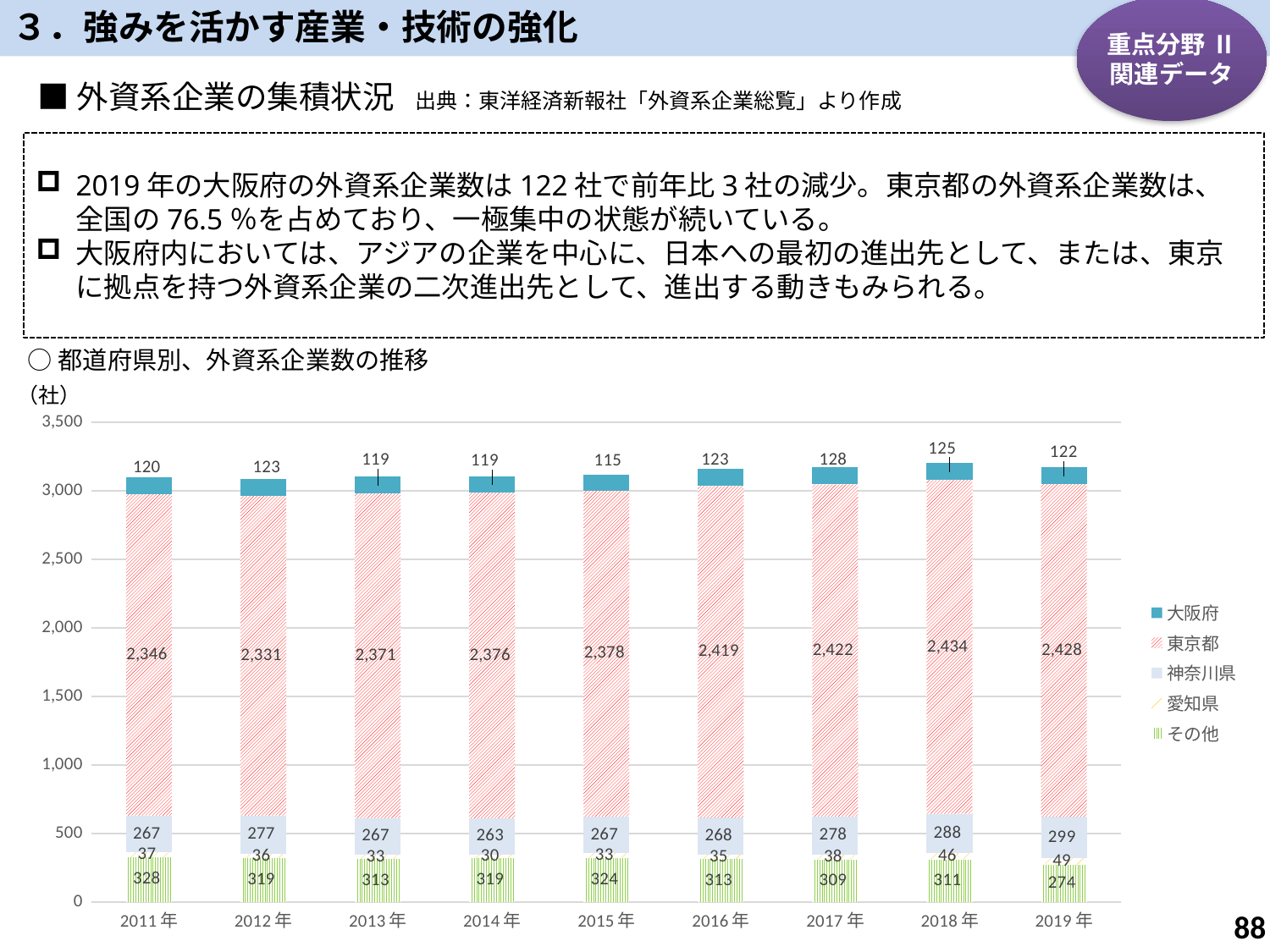
How many series does the legend list? 5 Which is larger, the その他 value in 2011年 or in 2019年? 2011年 What is the value for 大阪府 in 2019年? 122 In which year is the value for 大阪府 the highest? 2017年 What is the value for 神奈川県 in 2014年? 263 What kind of chart is this? stacked bar chart What is the total of the stacked bar for 2019年? 3,172 In which year is the value for 愛知県 the lowest? 2014年 What is the value for 東京都 in 2018年? 2,434 What is the difference between the 大阪府 values for 2018年 and 2019年? 3 How many years are shown on the x axis? 9 What is the value for その他 in 2019年? 274